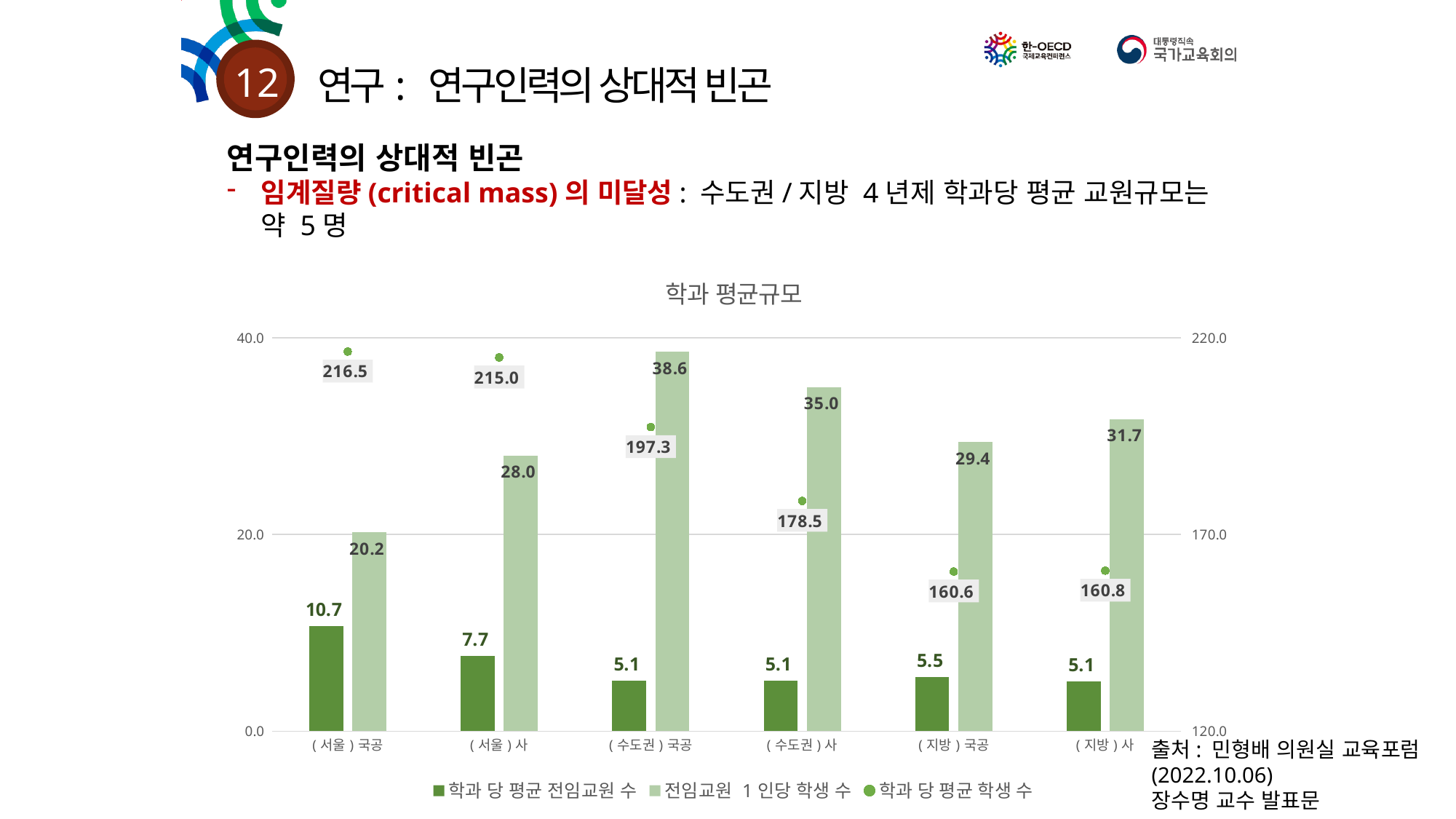
Which category has the highest 전임교원 1인당 학생 수? (수도권) 국공 What is the value of 학과 당 평균 전임교원 수 for (서울) 국공? 10.7 What is the difference between 학과 당 평균 전임교원 수 for (서울) 국공 and (서울) 사? 3.0 Which is larger, 전임교원 1인당 학생 수 for (수도권) 사 or for (지방) 사? (수도권) 사 What is the title of the chart? 학과 평균규모 Which category has the lowest 전임교원 1인당 학생 수? (서울) 국공 How many series does the legend list? 3 What kind of chart is this? Bar chart with a line/marker series How many categories are shown on the x axis? 6 What is the value of 학과 당 평균 학생 수 for (지방) 국공? 160.6 Which category has the highest 학과 당 평균 학생 수? (서울) 국공 What is the value of 전임교원 1인당 학생 수 for (수도권) 국공? 38.6